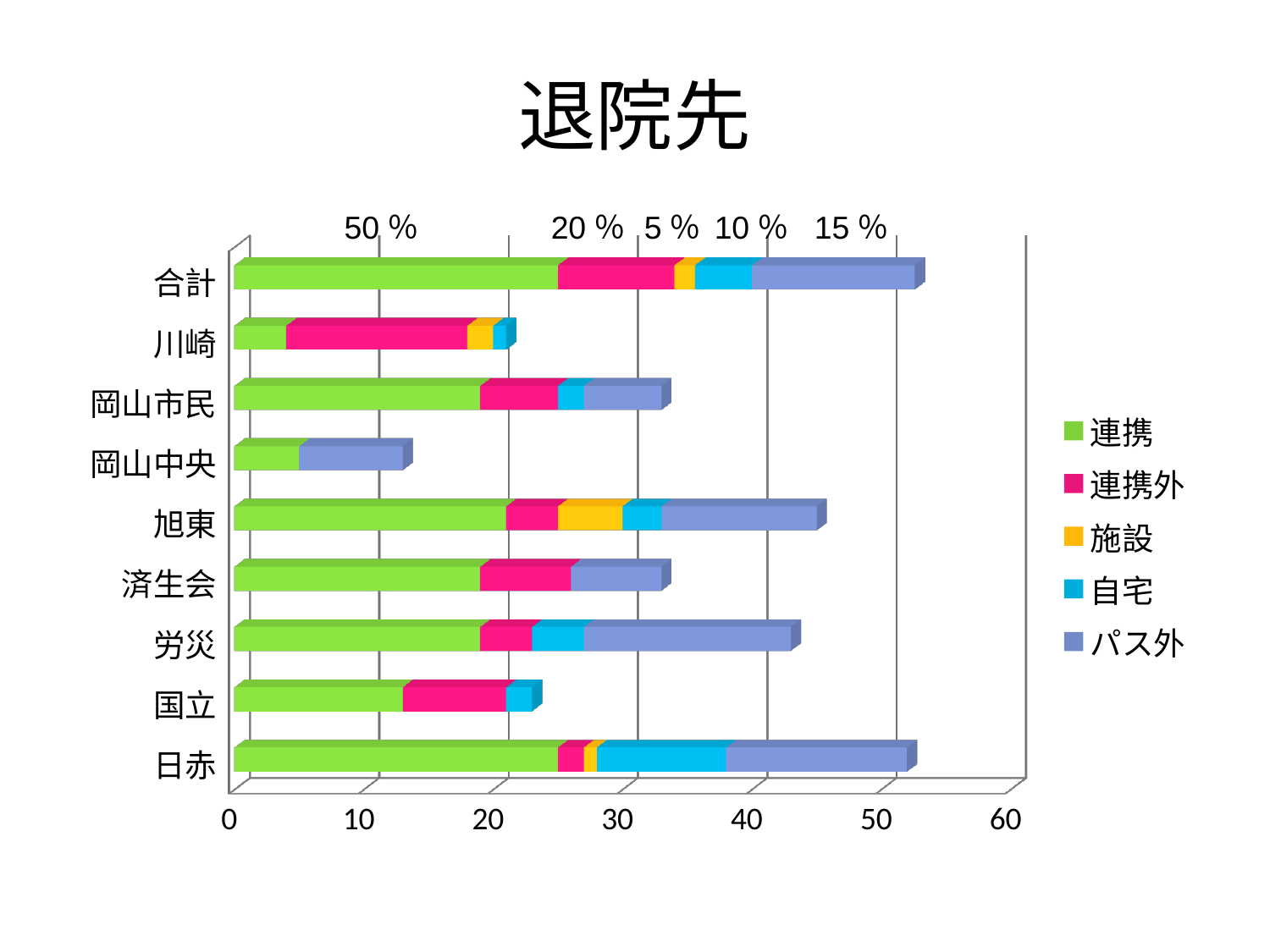
Excluding 合計, which category has the longest total bar? 日赤 Is the total bar length for 旭東 greater or less than 40? greater Which has the longer total bar, 国立 or 岡山市民? 岡山市民 How many categories are plotted on the vertical axis? 9 Which category has the shortest total bar? 岡山中央 What kind of chart is shown on the slide? stacked bar chart What is the title of the chart? 退院先 How many series does the legend list? 5 Which legend entry is shown in green? 連携 Which has the longer total bar, 旭東 or 済生会? 旭東 Is the total bar length for 川崎 greater or less than 30? less Is the total bar length for 岡山中央 greater or less than 20? less